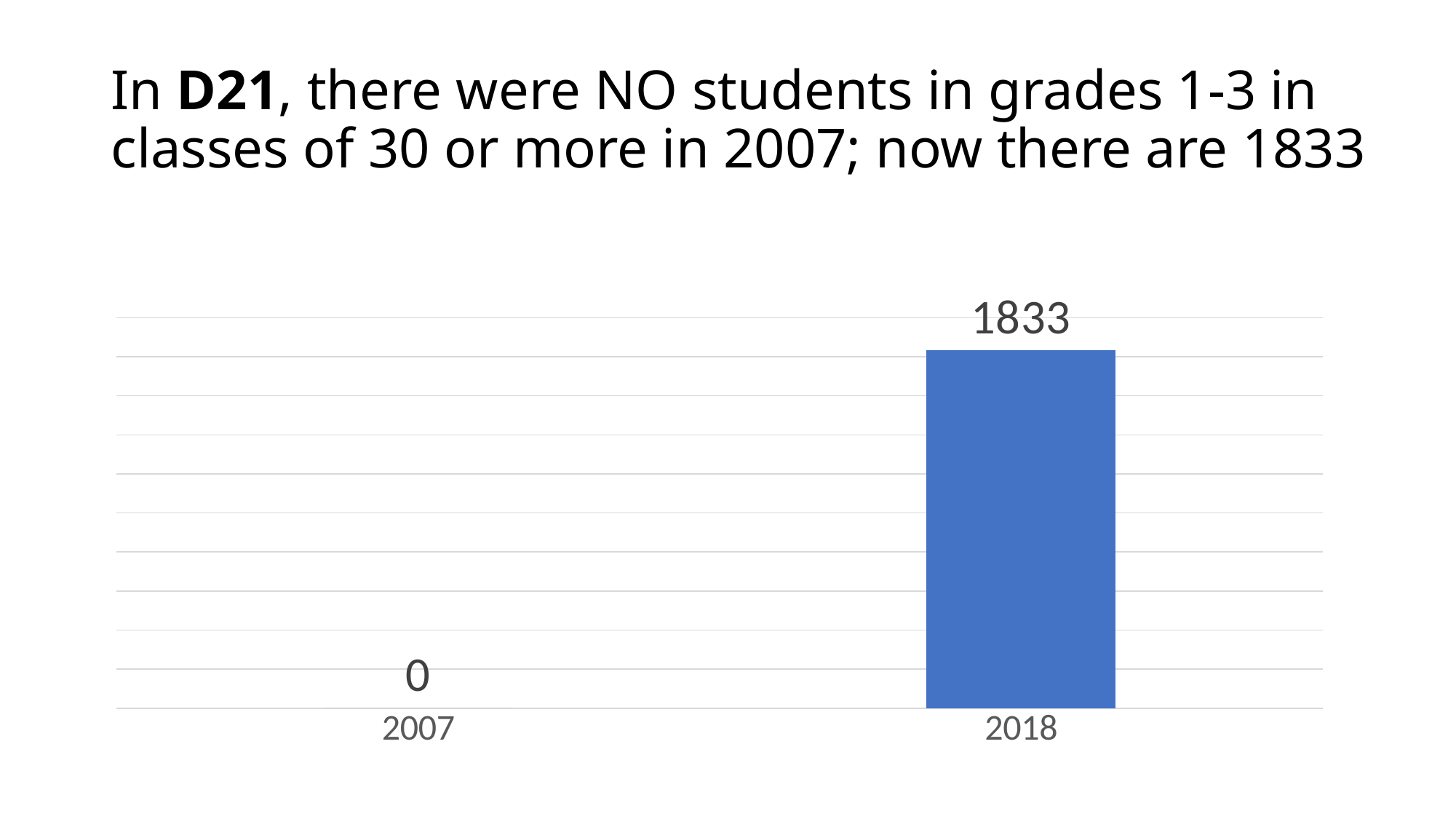
Which district does the slide title say the chart is about? D21 What kind of chart is shown on the slide? bar chart Which year has the lowest value? 2007 What is the difference between the values for 2018 and 2007? 1833 How many categories are shown on the x axis? 2 Do the values rise or fall from 2007 to 2018? rise Which year has the highest value? 2018 What is the value for 2018? 1833 Which is larger, the value for 2007 or the value for 2018? 2018 What is the value for 2007? 0 What colour is the bar for 2018? blue